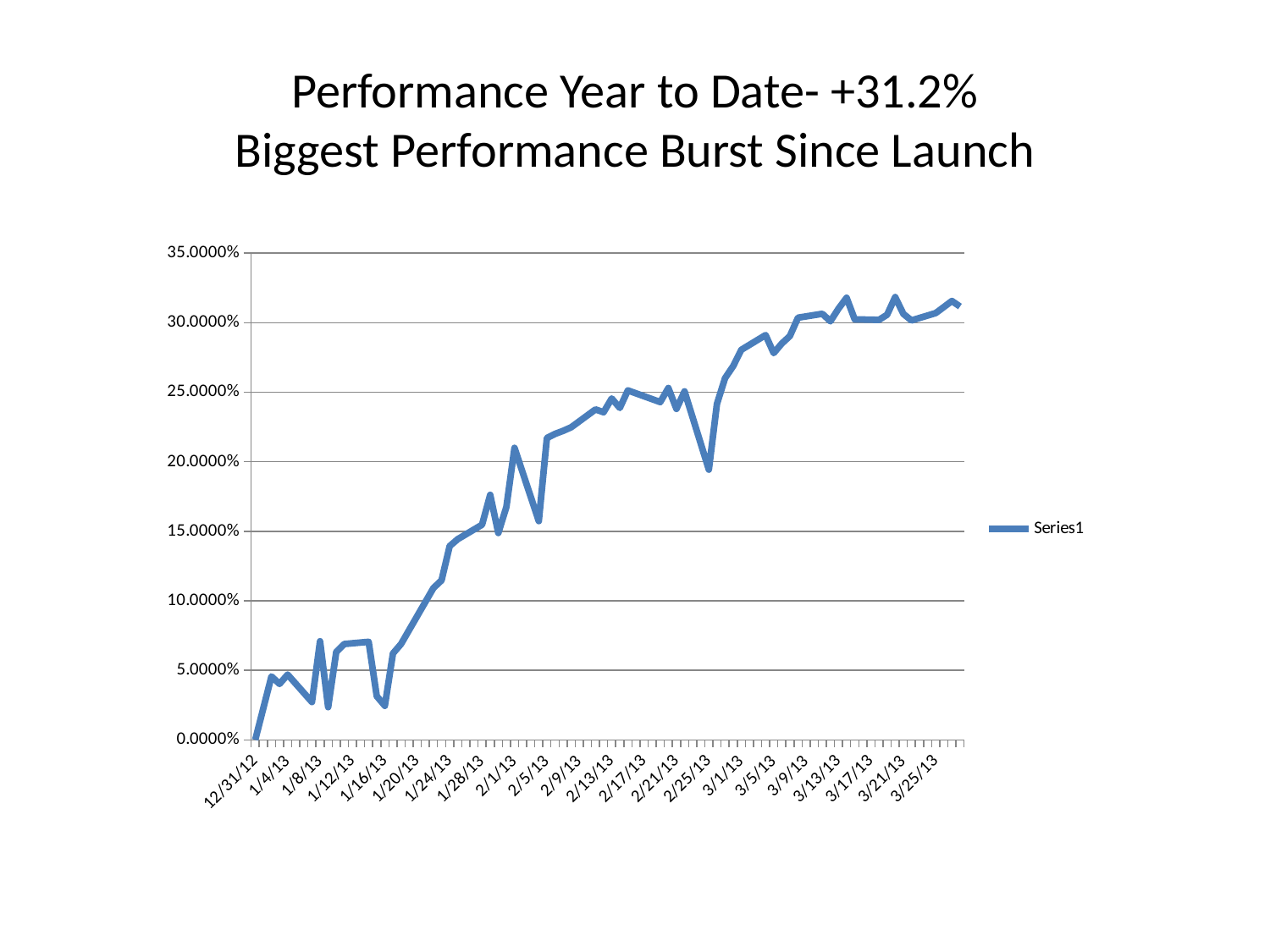
Overall, do the values rise or fall from 12/31/12 to 3/25/13? rise Is the value for 1/24/13 greater or less than 10.0000%? greater What is the value for 12/31/12, the first date on the x axis? 0.0000% Which date has the larger value, 1/24/13 or 2/9/13? 2/9/13 What is the highest value labelled on the y axis? 35.0000% What is the name of the series shown in the legend? Series1 How many series does the legend list? 1 What year-to-date performance figure is stated in the chart title? +31.2% Is the value for 1/16/13 greater or less than 5.0000%? less What kind of chart is shown on the slide? line chart Is the value for 3/25/13 greater or less than 30.0000%? greater